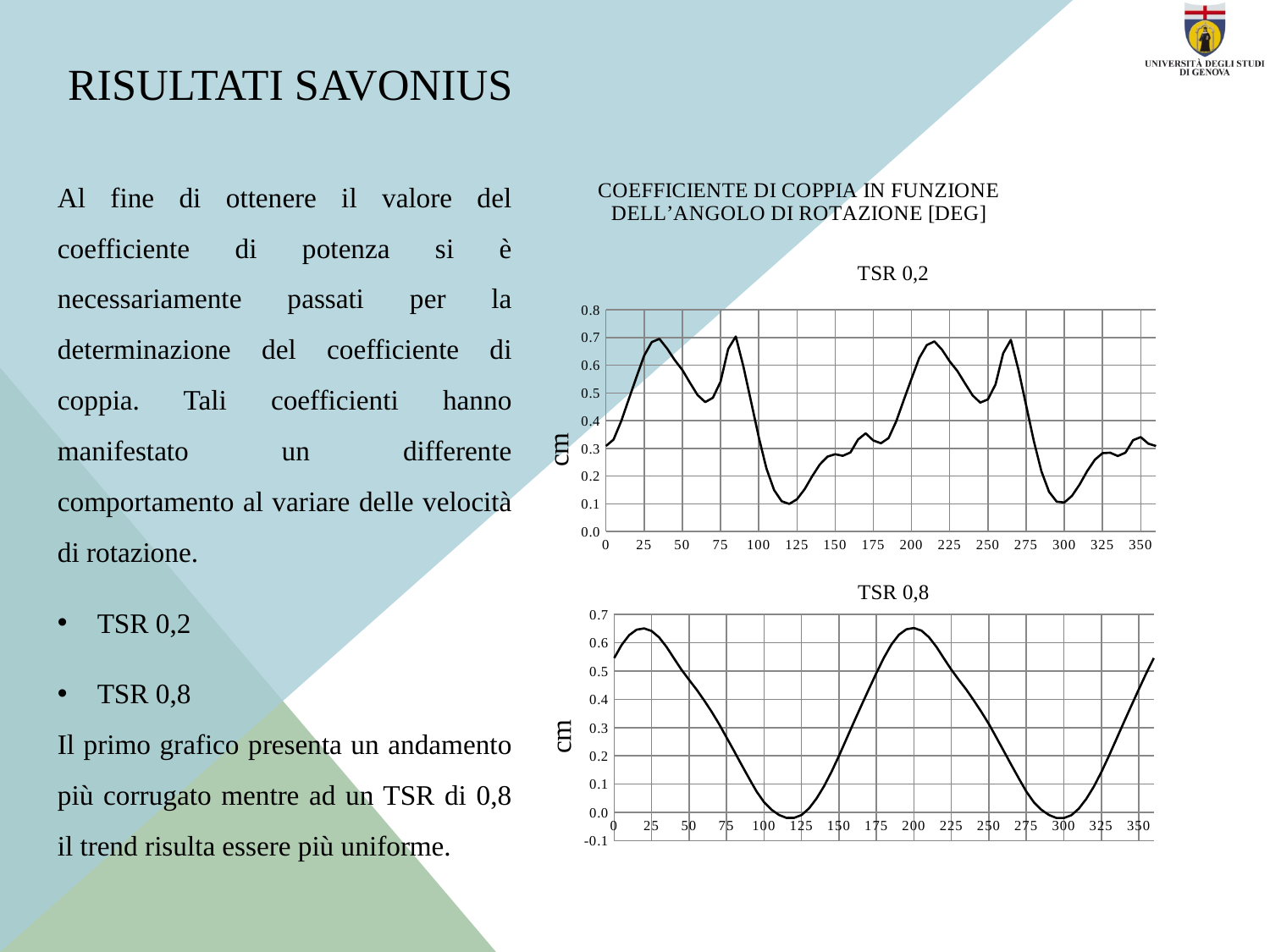
In the TSR 0,8 chart, does the curve rise or fall between rotation angles 125 and 200? rise In the TSR 0,8 chart, is the value at a rotation angle of 100 greater or less than 0.3? less What is the label on the vertical axis of the TSR 0,8 chart? cm What kind of chart is the TSR 0,8 chart? line chart In the TSR 0,2 chart, is the value at a rotation angle of 25 greater or less than 0.5? greater In the TSR 0,8 chart, is the value at a rotation angle of 200 greater or less than 0.5? greater What kind of chart is the TSR 0,2 chart? line chart In the TSR 0,8 chart, does the curve rise or fall between rotation angles 25 and 125? fall What is the highest tick value shown on the vertical axis of the TSR 0,2 chart? 0.8 In the TSR 0,2 chart, does the curve rise or fall between rotation angles 0 and 25? rise